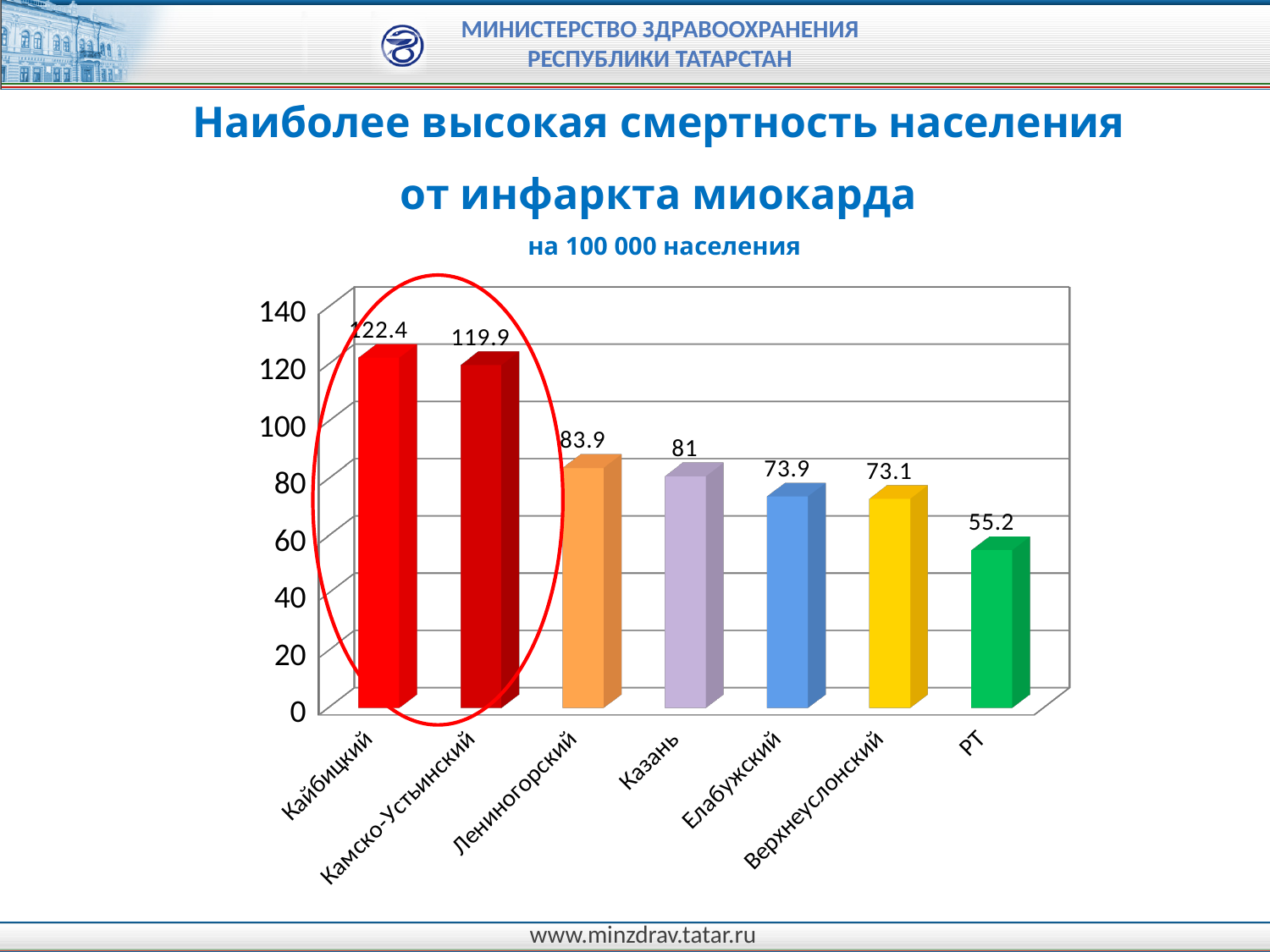
How many categories are shown on the x axis? 7 What is the difference between the values for Лениногорский and Казань? 2.9 What is the value for РТ? 55.2 What is the value for Камско-Устьинский? 119.9 What is the value for Казань? 81 Is the value for Верхнеуслонский greater or less than 80? less What is the difference between the values for Кайбицкий and РТ? 67.2 Which category has the highest value? Кайбицкий Which is larger, the value for Елабужский or the value for РТ? Елабужский What kind of chart is shown on the slide? bar chart What is the value for Кайбицкий? 122.4 Which category has the lowest value? РТ